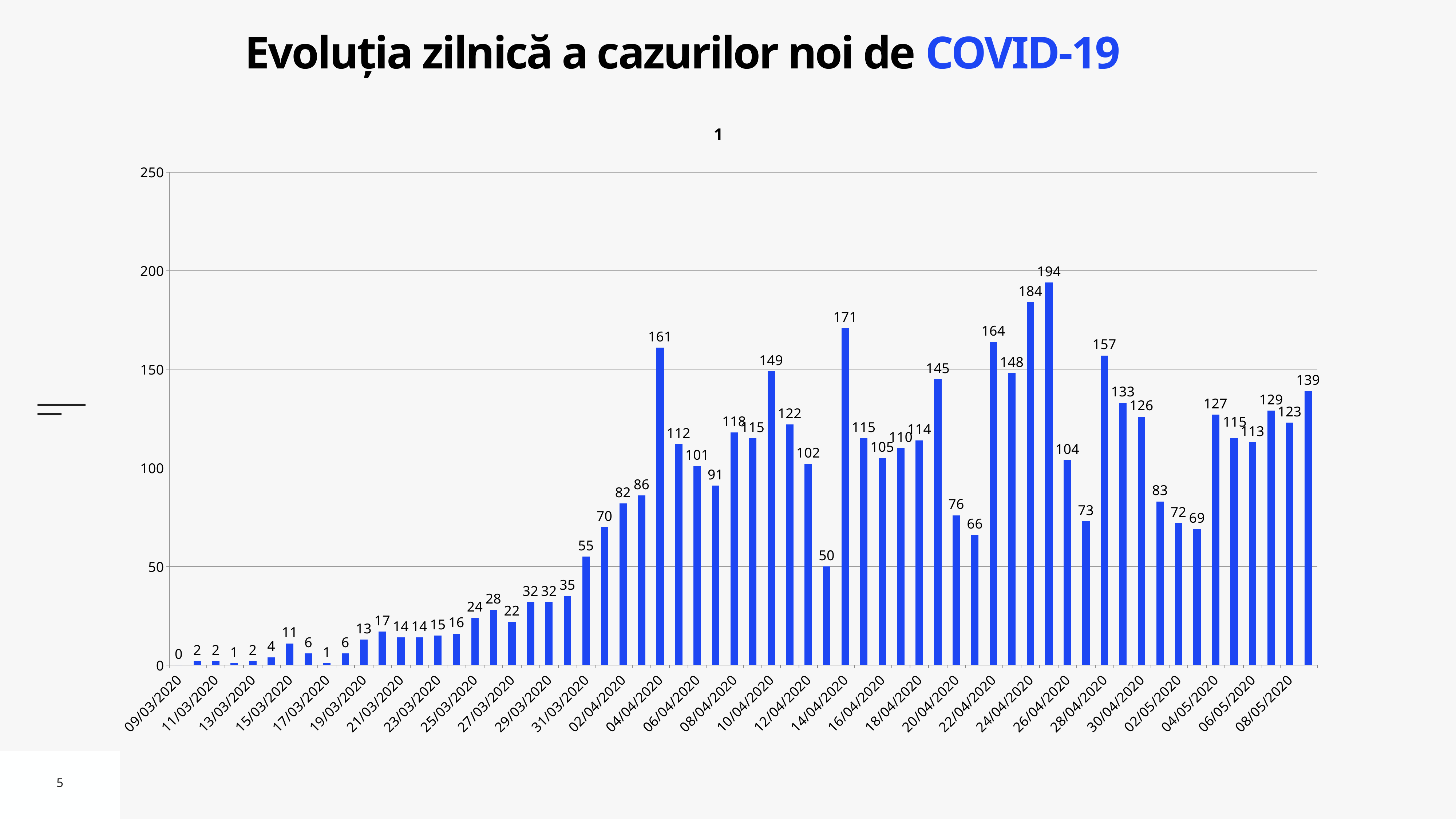
What is the highest daily value shown in the chart? 194 What is the value for 14/04/2020? 171 Which date has the lowest value in the chart? 09/03/2020 Do the values generally rise or fall from 09/03/2020 to 04/04/2020? rise Is the value for 28/04/2020 greater or less than 150? greater What is the difference between the values for 22/04/2020 and 20/04/2020? 88 What is the title of the chart on the slide? Evoluția zilnică a cazurilor noi de COVID-19 What kind of chart is shown on the slide? bar chart What is the value for 24/04/2020? 184 What is the value for 08/05/2020? 123 Which is larger, the value for 10/04/2020 or the value for 12/04/2020? 10/04/2020 What is the value for 04/04/2020? 161